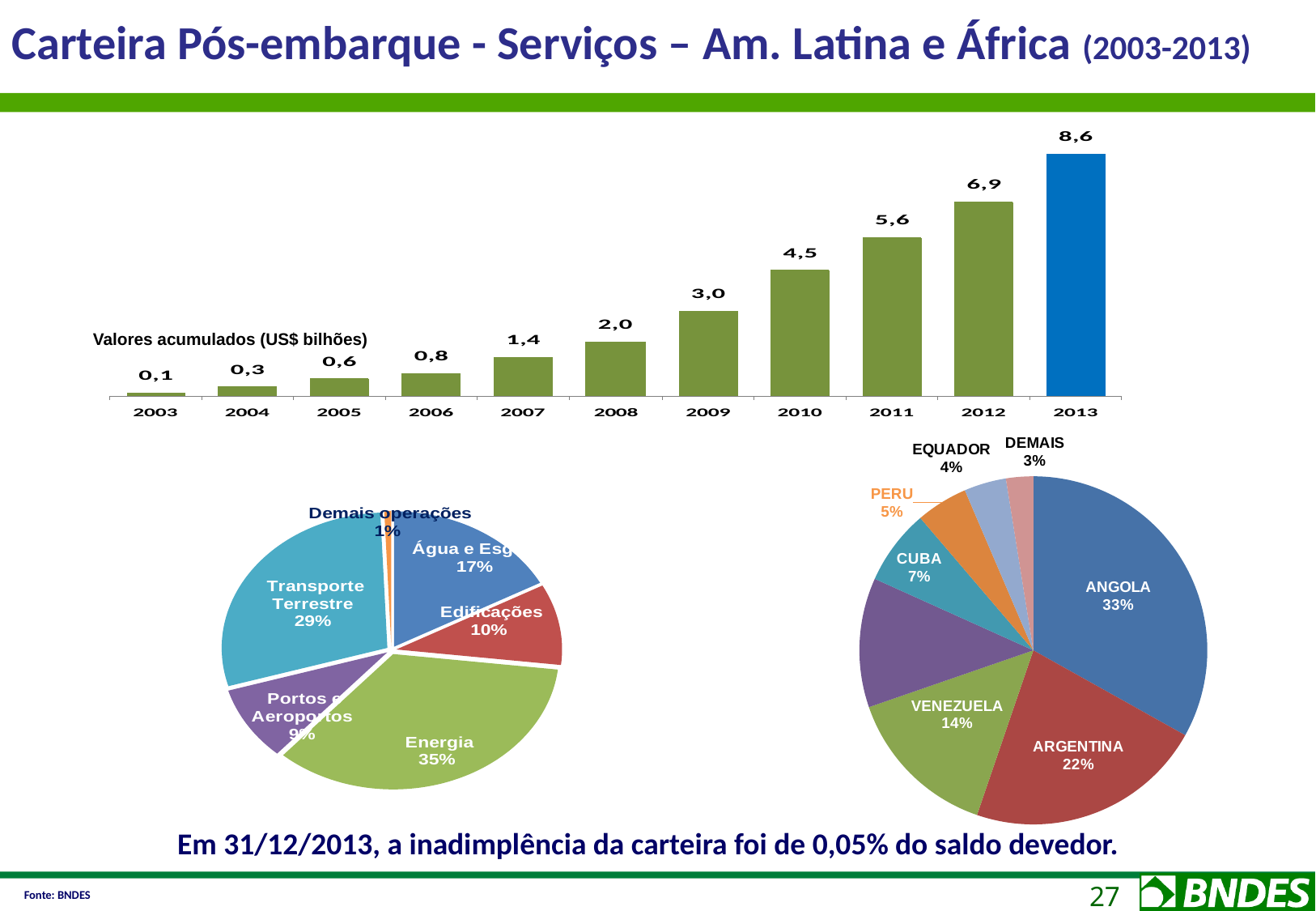
In the top bar chart, what is the value for 2009? 3,0 What kind of chart is the top chart on the slide? bar chart In the bottom-right pie chart, which is larger, Venezuela or Cuba? Venezuela In the bottom-right pie chart, what share does Angola have? 33% In the top bar chart, how many years are shown on the x axis? 11 In the bottom-left pie chart, which slice is the smallest? Demais operações In the bottom-left pie chart, what share does Energia have? 35% In the bottom-right pie chart, what is the difference between the shares of Argentina and Peru? 17% In the top bar chart, which year has the lowest value? 2003 In the top bar chart, do the values rise or fall from 2003 to 2013? rise In the top bar chart, what is the difference between the values for 2013 and 2012? 1,7 In the top bar chart, what is the value for 2013? 8,6